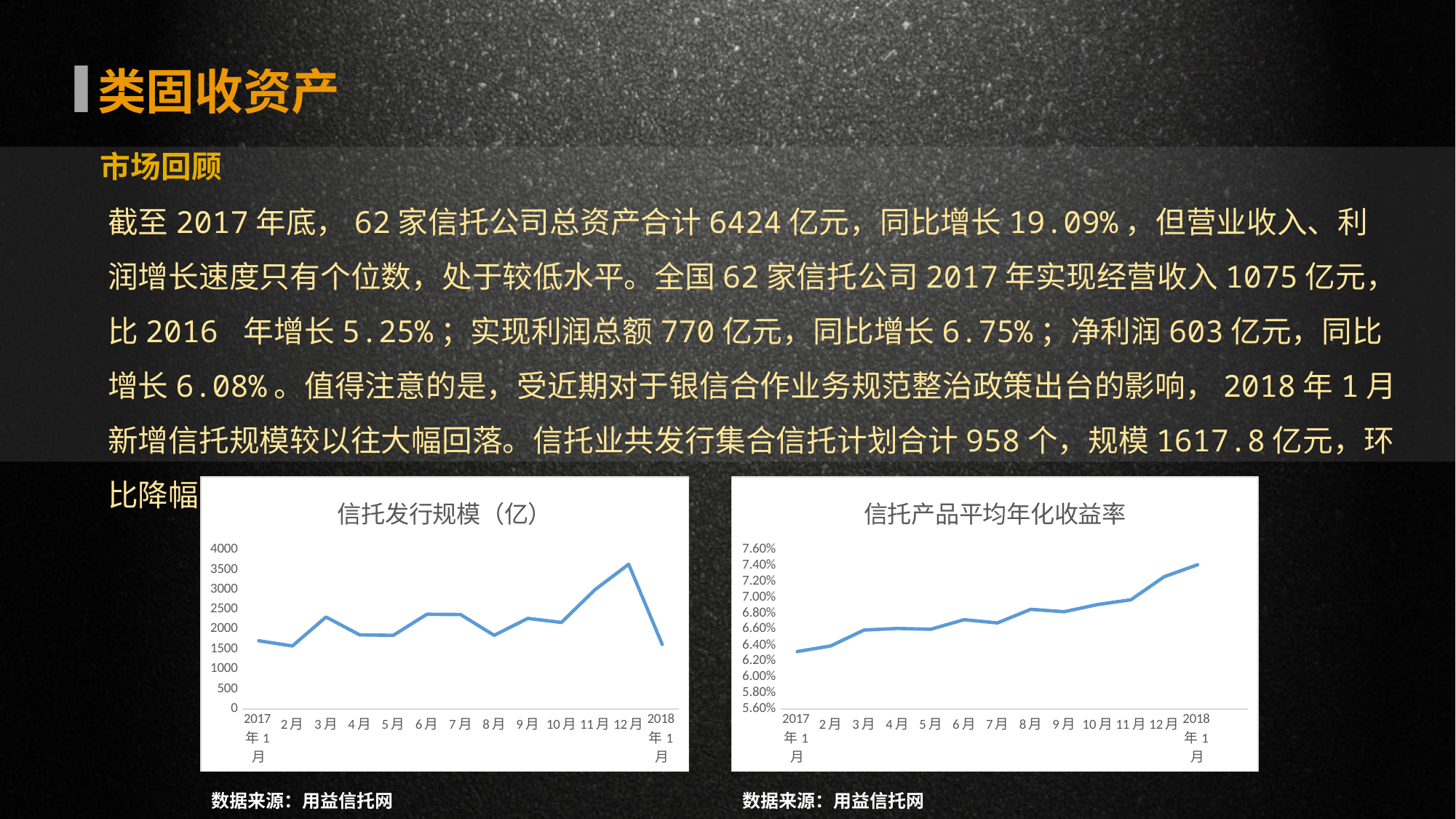
What is the source cited below the right chart 信托产品平均年化收益率? 用益信托网 In the right chart 信托产品平均年化收益率, is the value for 2018年1月 greater or less than 7.20%? greater What kind of chart is the right chart titled 信托产品平均年化收益率? line chart In the right chart 信托产品平均年化收益率, which month has the lowest value? 2017年1月 In the right chart 信托产品平均年化收益率, do the values generally rise or fall from 2017年1月 to 2018年1月? rise What kind of chart is the left chart titled 信托发行规模（亿）? line chart In the left chart 信托发行规模（亿）, is the value for 2月 greater or less than 2000? less In the left chart 信托发行规模（亿）, which is larger, the value for 12月 or the value for 2018年1月? 12月 In the left chart 信托发行规模（亿）, which month has the highest value? 12月 In the left chart 信托发行规模（亿）, is the value for 12月 greater or less than 3000? greater How many data points are plotted in the left chart 信托发行规模（亿）? 13 In the right chart 信托产品平均年化收益率, which month has the highest value? 2018年1月